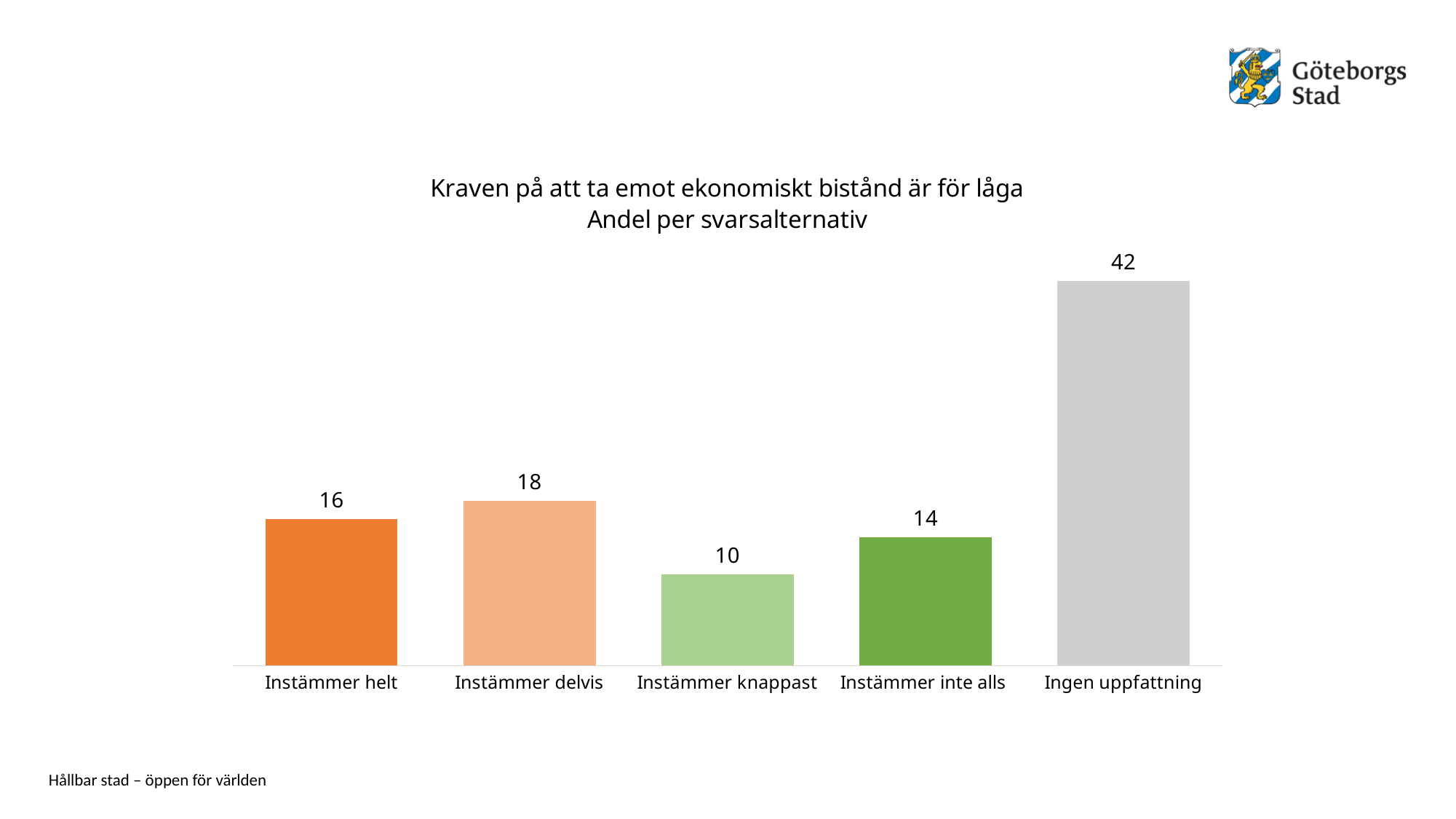
What is the difference between the values for Ingen uppfattning and Instämmer delvis? 24 How many categories are shown in the chart? 5 What kind of chart is shown on the slide? Bar chart What is the value for Instämmer helt? 16 Which category has the highest value? Ingen uppfattning What is the title of the chart? Kraven på att ta emot ekonomiskt bistånd är för låga Andel per svarsalternativ What is the value for Ingen uppfattning? 42 What is the value for Instämmer delvis? 18 What is the value for Instämmer knappast? 10 Which is larger, the value for Instämmer delvis or the value for Instämmer inte alls? Instämmer delvis Which category has the lowest value? Instämmer knappast What is the difference between the values for Instämmer helt and Instämmer inte alls? 2